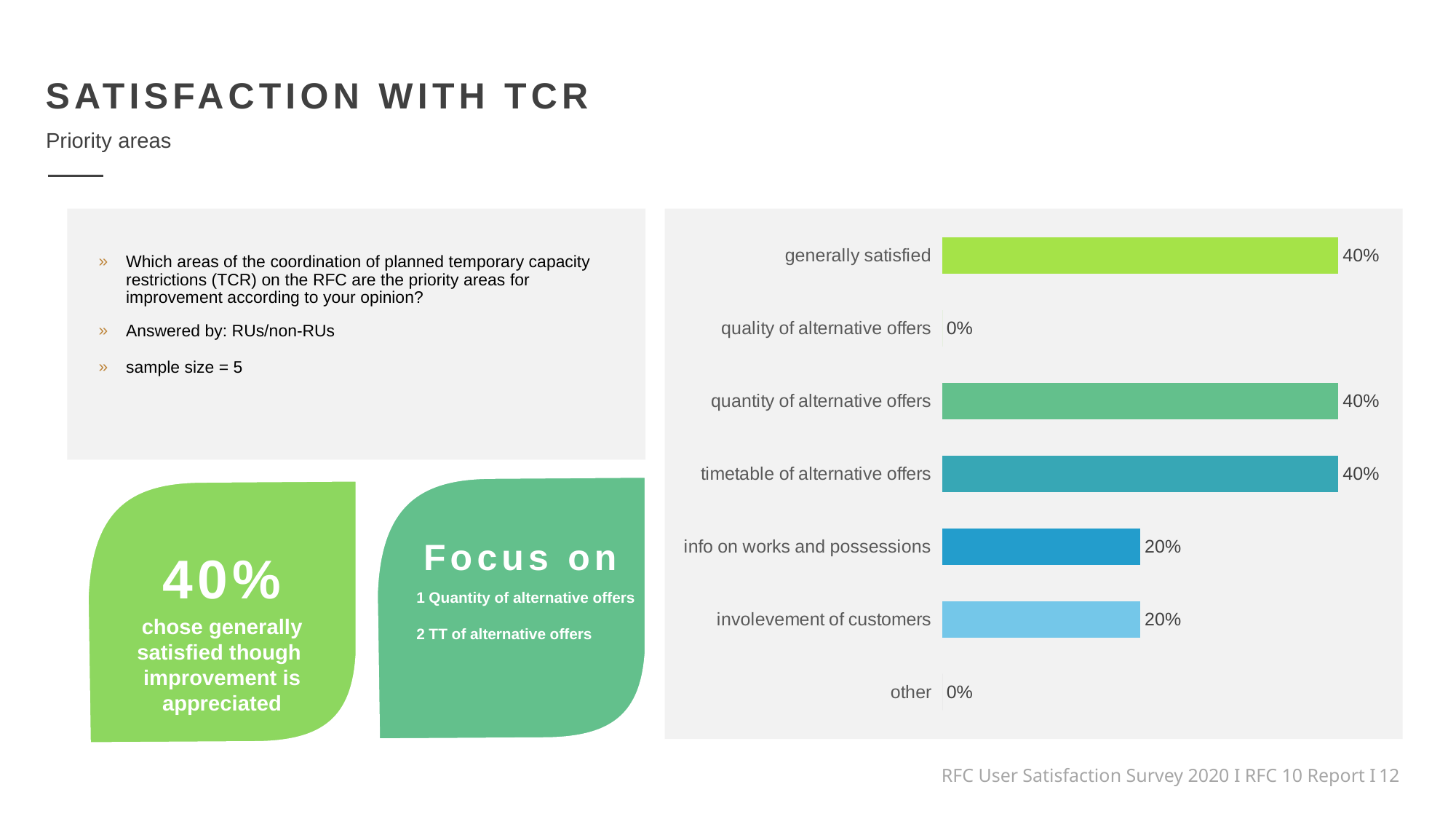
What is the value for 'involevement of customers'? 20% What kind of chart is shown on the slide? bar chart How many categories are shown in the chart? 7 What is the value for 'other'? 0% How many categories have a value of 40%? 3 Which category is listed first (at the top) of the chart? generally satisfied What is the value for 'generally satisfied'? 40% What is the value for 'info on works and possessions'? 20% How many categories have a value of 0%? 2 What is the difference between 'quantity of alternative offers' and 'info on works and possessions'? 20% Which is larger, 'timetable of alternative offers' or 'involevement of customers'? timetable of alternative offers What is the value for 'quality of alternative offers'? 0%